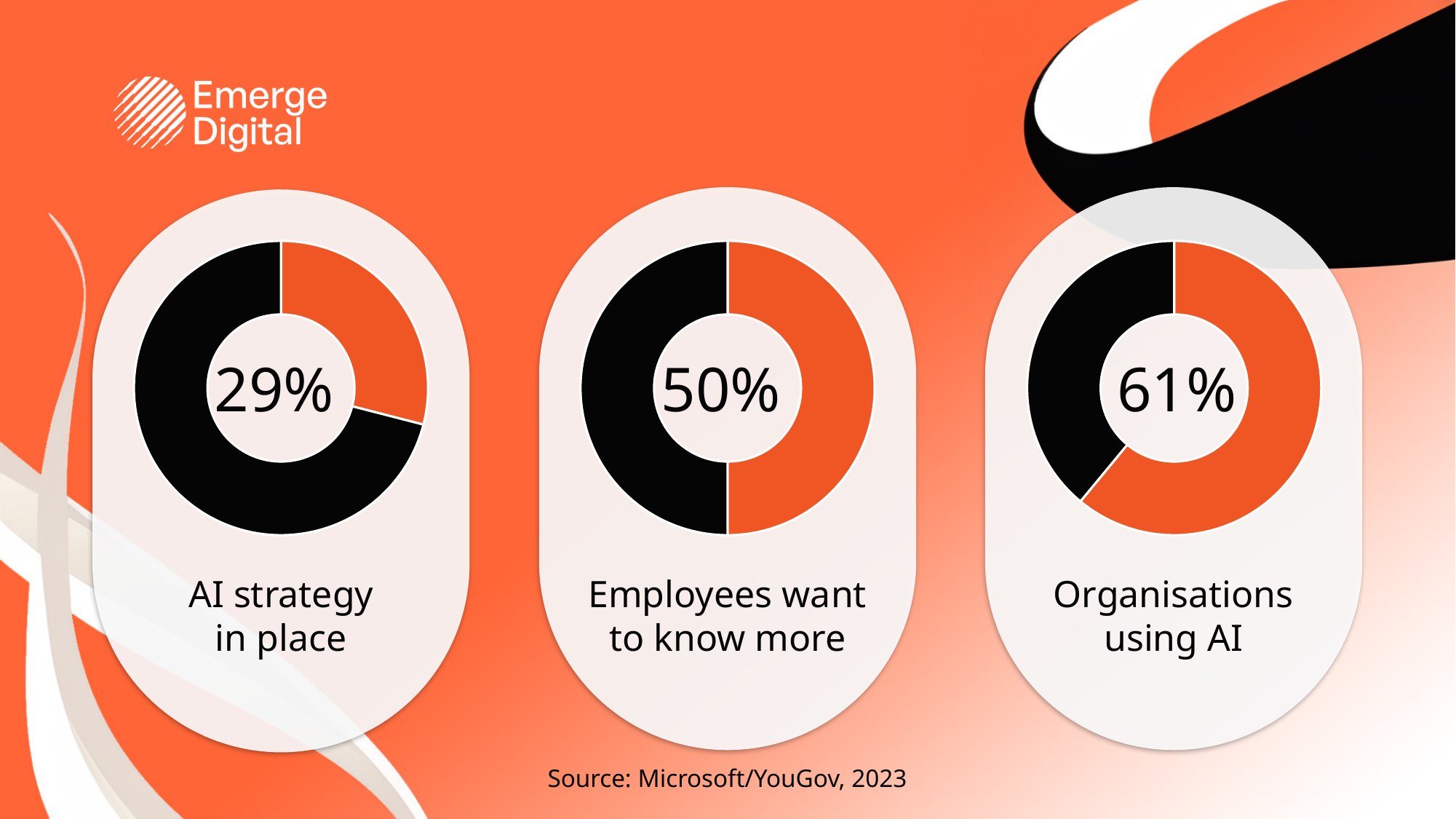
Which is larger: the percentage in the 'Employees want to know more' chart or the percentage in the 'Organisations using AI' chart? Organisations using AI Across the three donut charts, which one shows the highest percentage? Organisations using AI What percentage is shown in the 'Employees want to know more' donut chart? 50% What is the difference between the percentage in the 'Employees want to know more' chart and the percentage in the 'AI strategy in place' chart? 21% What source is cited for the data in the three donut charts? Microsoft/YouGov, 2023 In the 'Organisations using AI' donut chart, what share of the ring is filled in orange? 61% What percentage is shown in the 'Organisations using AI' donut chart? 61% What kind of chart is used to show the 'AI strategy in place' figure? Donut chart What is the difference between the percentage in the 'Organisations using AI' chart and the percentage in the 'AI strategy in place' chart? 32% How many donut charts are shown on the slide? 3 Across the three donut charts, which one shows the lowest percentage? AI strategy in place What percentage is shown in the 'AI strategy in place' donut chart? 29%